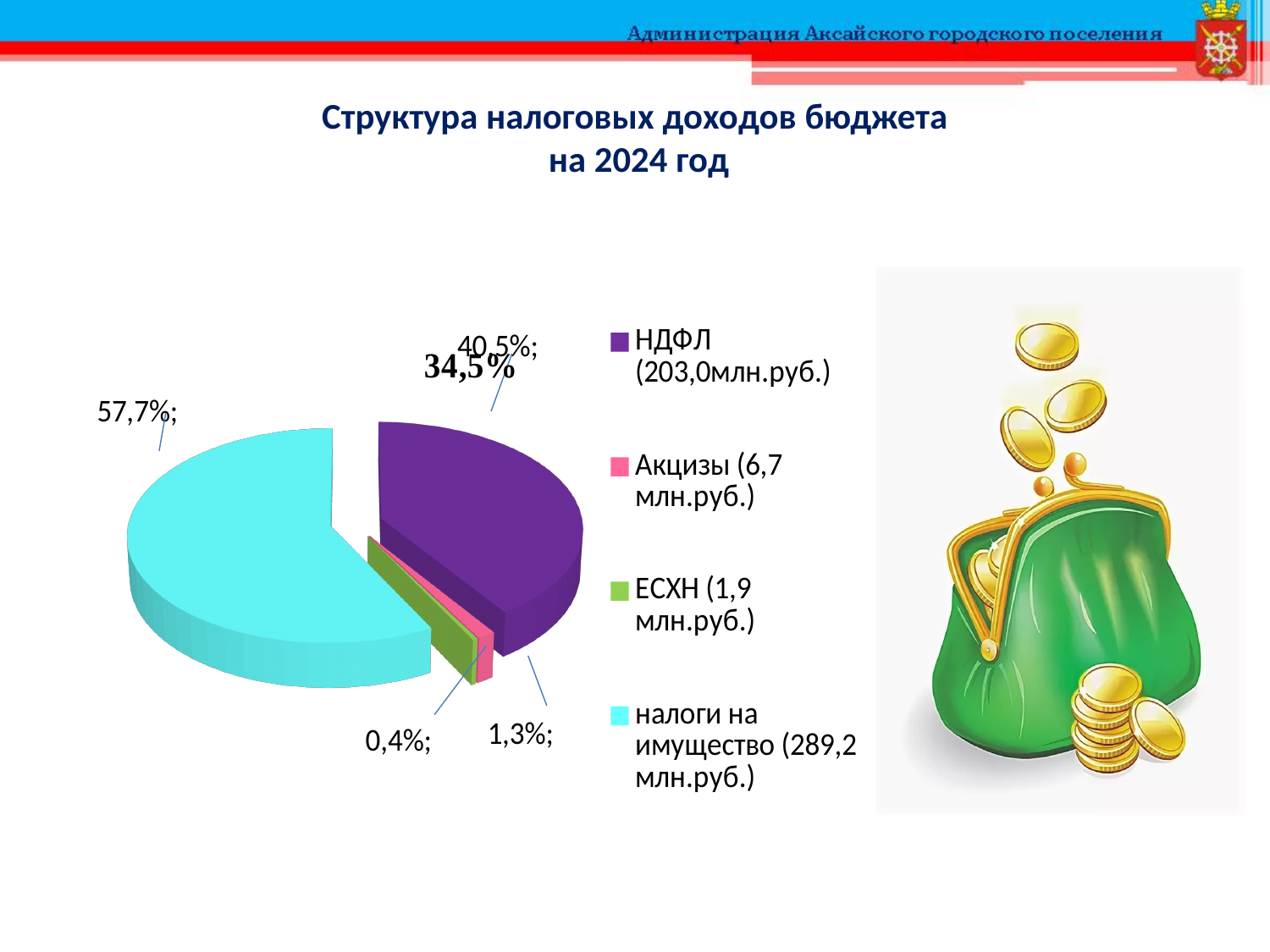
Which category has the smallest slice of the pie? ЕСХН What kind of chart is shown on the slide? pie chart What share of the pie does ЕСХН have? 0,4% Which category has the largest slice of the pie? налоги на имущество What colour is the НДФЛ slice in the pie chart? purple Which slice is larger, Акцизы or ЕСХН? Акцизы What share of the pie does Акцизы have? 1,3% How many slices does the pie chart have? 4 How many entries does the legend of the pie chart list? 4 What is the difference in percentage points between the Акцизы slice and the ЕСХН slice? 0,9% According to the legend, what amount in млн.руб. is given for налоги на имущество? 289,2 млн.руб. What share of the pie does налоги на имущество have? 57,7%